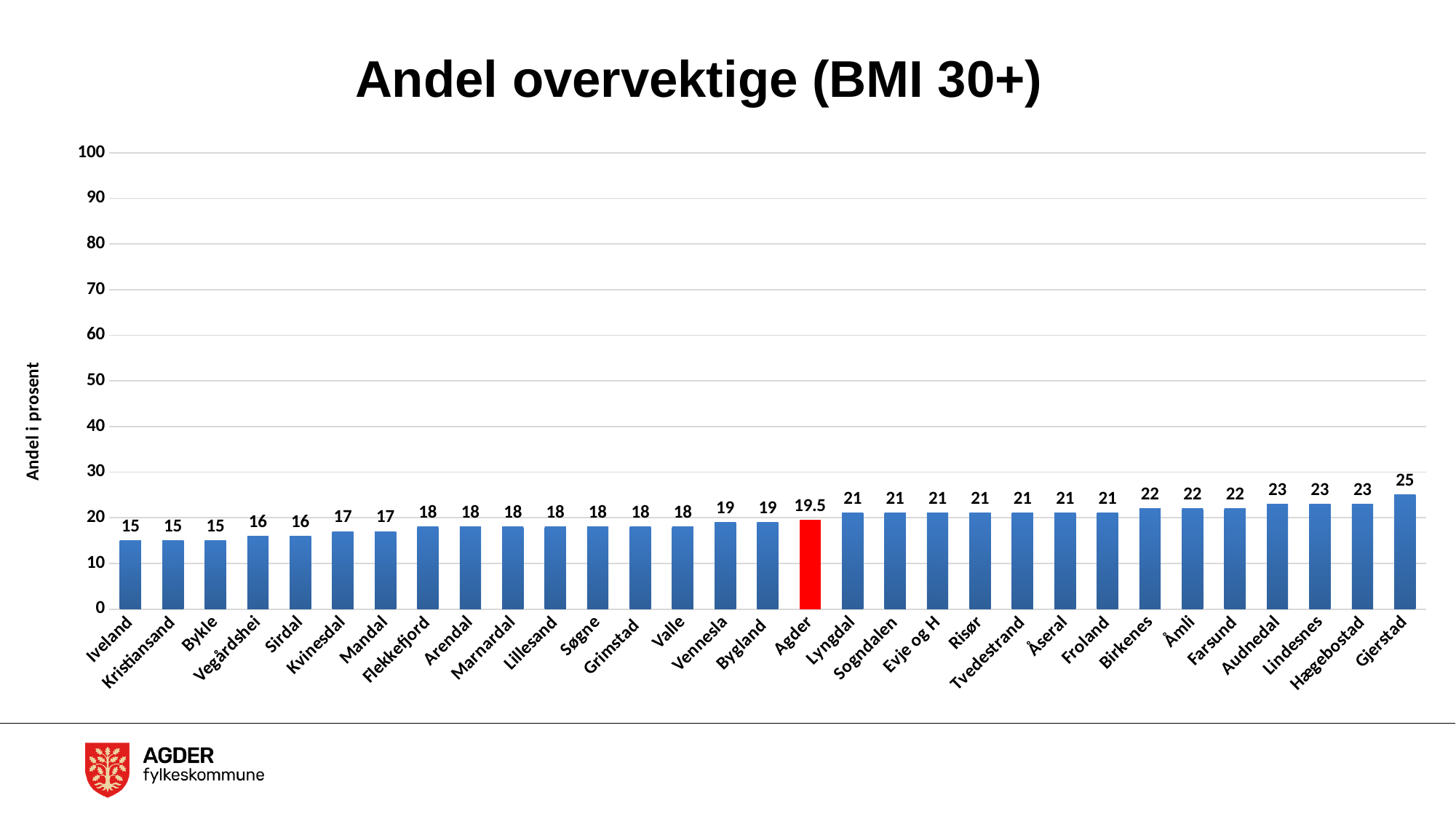
What is the difference between the values for Lyngdal and Agder? 1.5 What is the value for Vennesla? 19 What is the value for Agder? 19.5 How many categories are shown on the x axis? 31 Which category has the highest value? Gjerstad What is the value for Gjerstad? 25 What is the value for Kristiansand? 15 Which bar is coloured red instead of blue? Agder What kind of chart is shown on the slide? bar chart Which is larger, the value for Audnedal or the value for Sirdal? Audnedal What is the difference between the values for Gjerstad and Iveland? 10 Is the value for Birkenes greater or less than 30? less